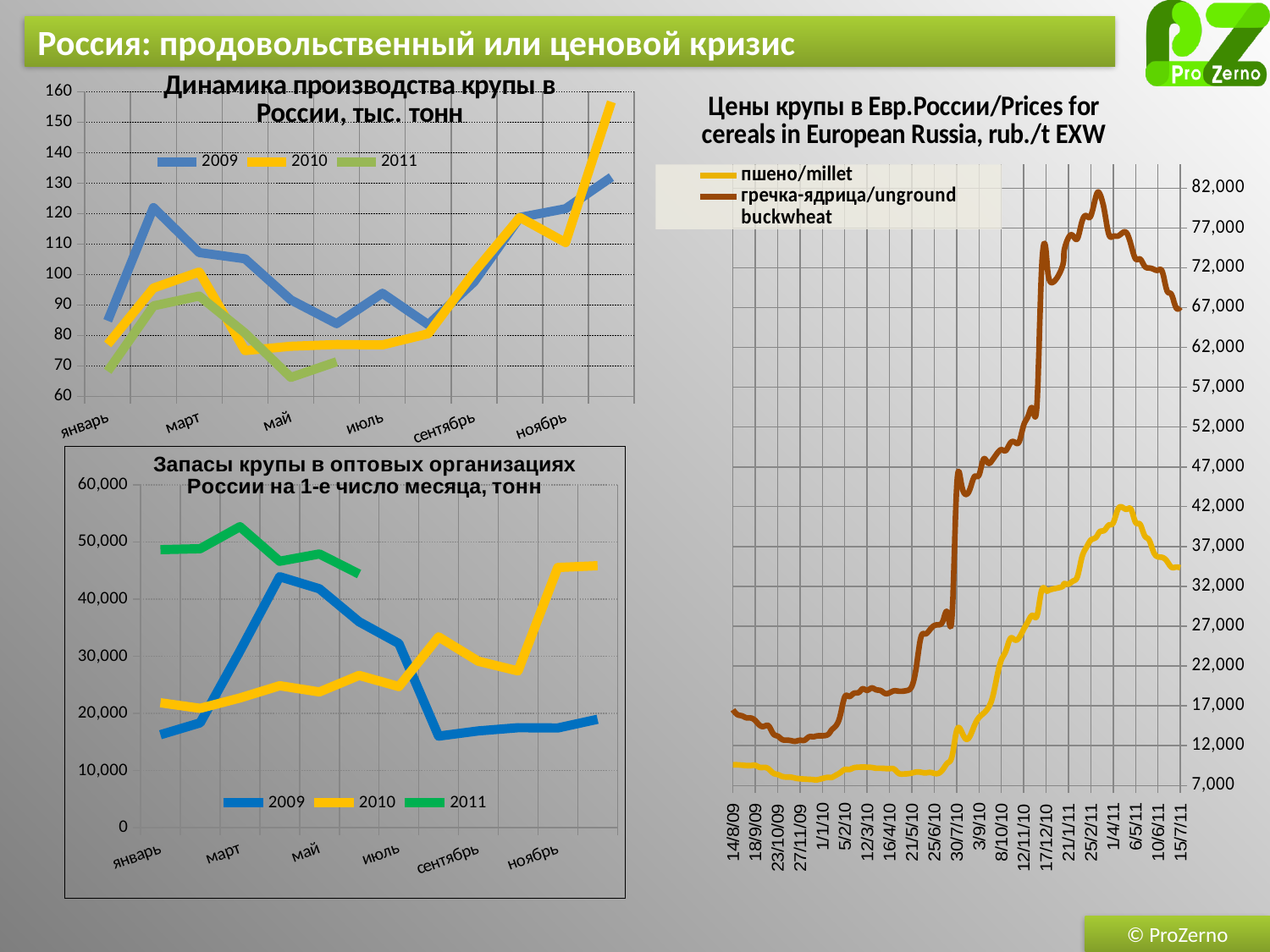
In the bottom-left chart ("Запасы крупы в оптовых организациях России"), is the value for 2011 in март greater or less than 50,000? greater In the bottom-left chart ("Запасы крупы в оптовых организациях России"), is the value for 2009 in сентябрь greater or less than 20,000? less In the right chart ("Prices for cereals in European Russia"), does the гречка-ядрица/unground buckwheat line rise or fall from 14/8/09 to 25/2/11? rise What kind of chart is the bottom-left chart titled "Запасы крупы в оптовых организациях России на 1-е число месяца, тонн"? line chart How many series does the legend of the right chart ("Цены крупы в Евр.России/Prices for cereals in European Russia") list? 2 In the bottom-left chart ("Запасы крупы в оптовых организациях России"), which series has the larger value in сентябрь, 2009 or 2010? 2010 How many series does the legend of the top-left chart ("Динамика производства крупы в России") list? 3 In the top-left chart ("Динамика производства крупы в России"), is the value for 2010 at the last point of the year greater or less than 150? greater What kind of chart is the top-left chart titled "Динамика производства крупы в России, тыс. тонн"? line chart In the top-left chart ("Динамика производства крупы в России"), which series has the larger value in май, 2009 or 2011? 2009